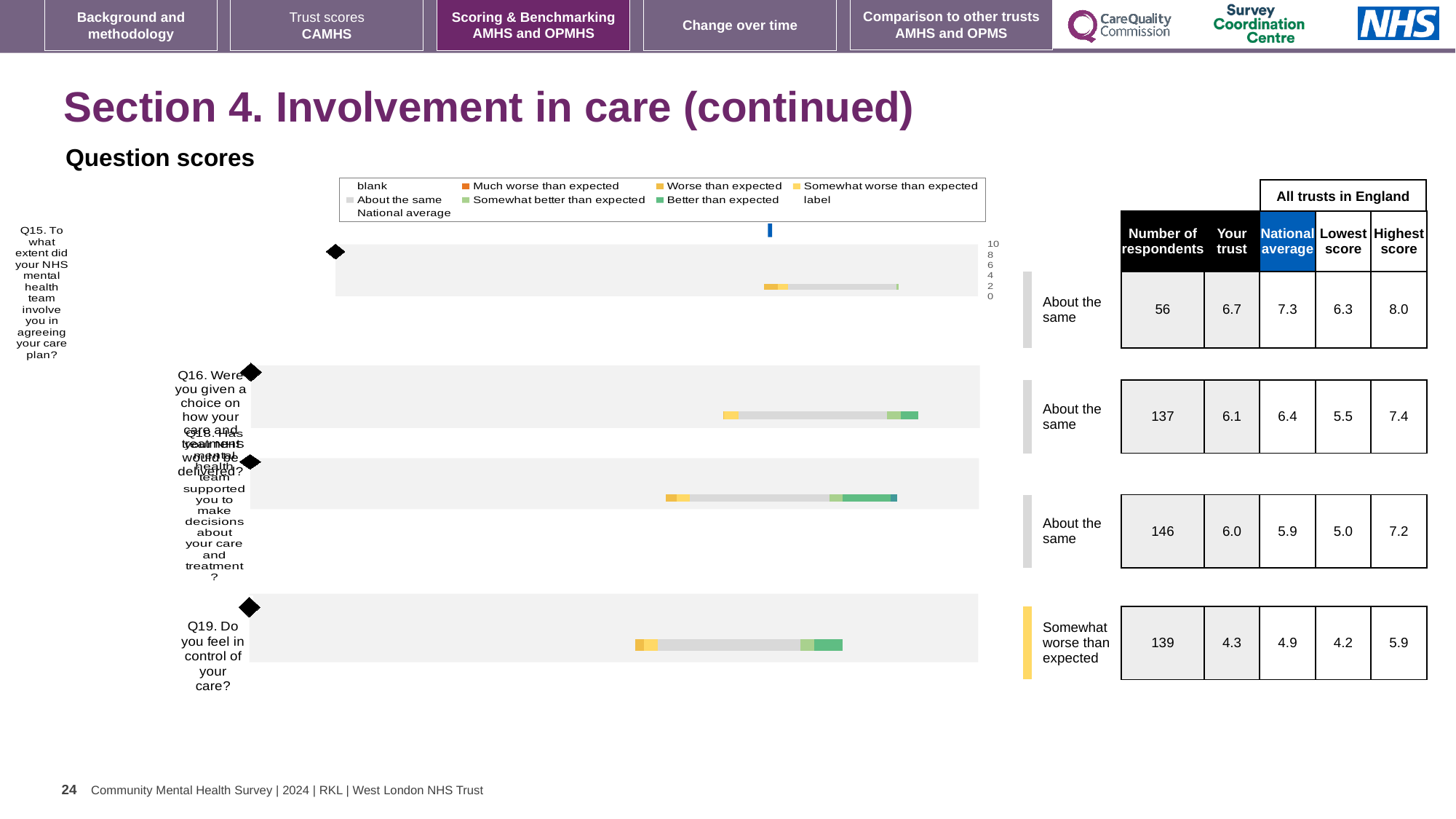
How many questions (bars) are plotted in the question scores chart? 4 What is the heading above the 'National average', 'Lowest score' and 'Highest score' columns in the table beside the chart? All trusts in England According to the table next to the chart, how many respondents answered Q15 (involvement in agreeing your care plan)? 56 Which benchmark category is shown for Q19 (Do you feel in control of your care?)? Somewhat worse than expected For Q18, is the 'Your trust' score (6.0) higher or lower than the national average (5.9)? higher What is the national average score for Q16 (choice on how care and treatment would be delivered)? 6.4 What is the difference between the highest score (8.0) and the lowest score (6.3) for Q15? 1.7 What is the highest score among all trusts in England for Q18? 7.2 What kind of chart is used to show the question scores on this slide? bar chart What is the 'Your trust' score for Q19 (Do you feel in control of your care?) in the table beside the chart? 4.3 Which question has the lowest 'Your trust' score? Q19 Which question has the highest number of respondents in the table beside the chart? Q18